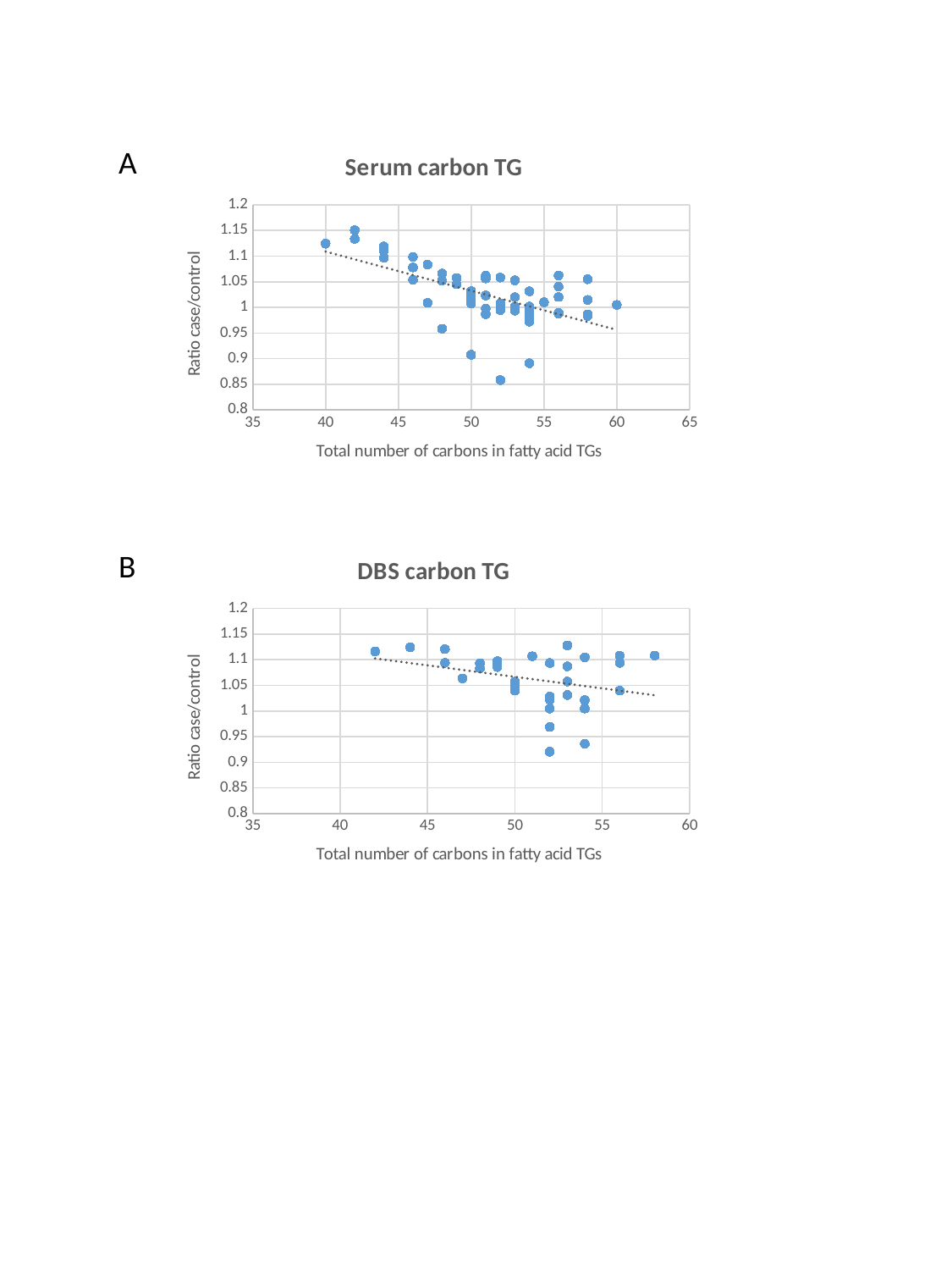
In the Serum carbon TG chart, is the lowest plotted point (at 52 carbons) greater or less than 0.9? less Which chart's x axis extends to 65: Serum carbon TG or DBS carbon TG? Serum carbon TG In the Serum carbon TG chart, which has the higher ratio: the point at 40 carbons or the point at 60 carbons? 40 carbons In the DBS carbon TG chart, is the ratio for the point at 42 carbons greater or less than 1.1? greater In the DBS carbon TG chart, is the lowest plotted point (at 52 carbons) greater or less than 0.95? less In the DBS carbon TG chart, does the dotted trend line rise or fall as the total number of carbons increases? fall What is the x-axis label of the Serum carbon TG chart? Total number of carbons in fatty acid TGs What kind of chart is the DBS carbon TG chart? scatter chart What kind of chart is the Serum carbon TG chart? scatter chart In the DBS carbon TG chart, which has the higher ratio: the point at 44 carbons or the point at 47 carbons? 44 carbons In the Serum carbon TG chart, does the dotted trend line rise or fall as the total number of carbons increases? fall